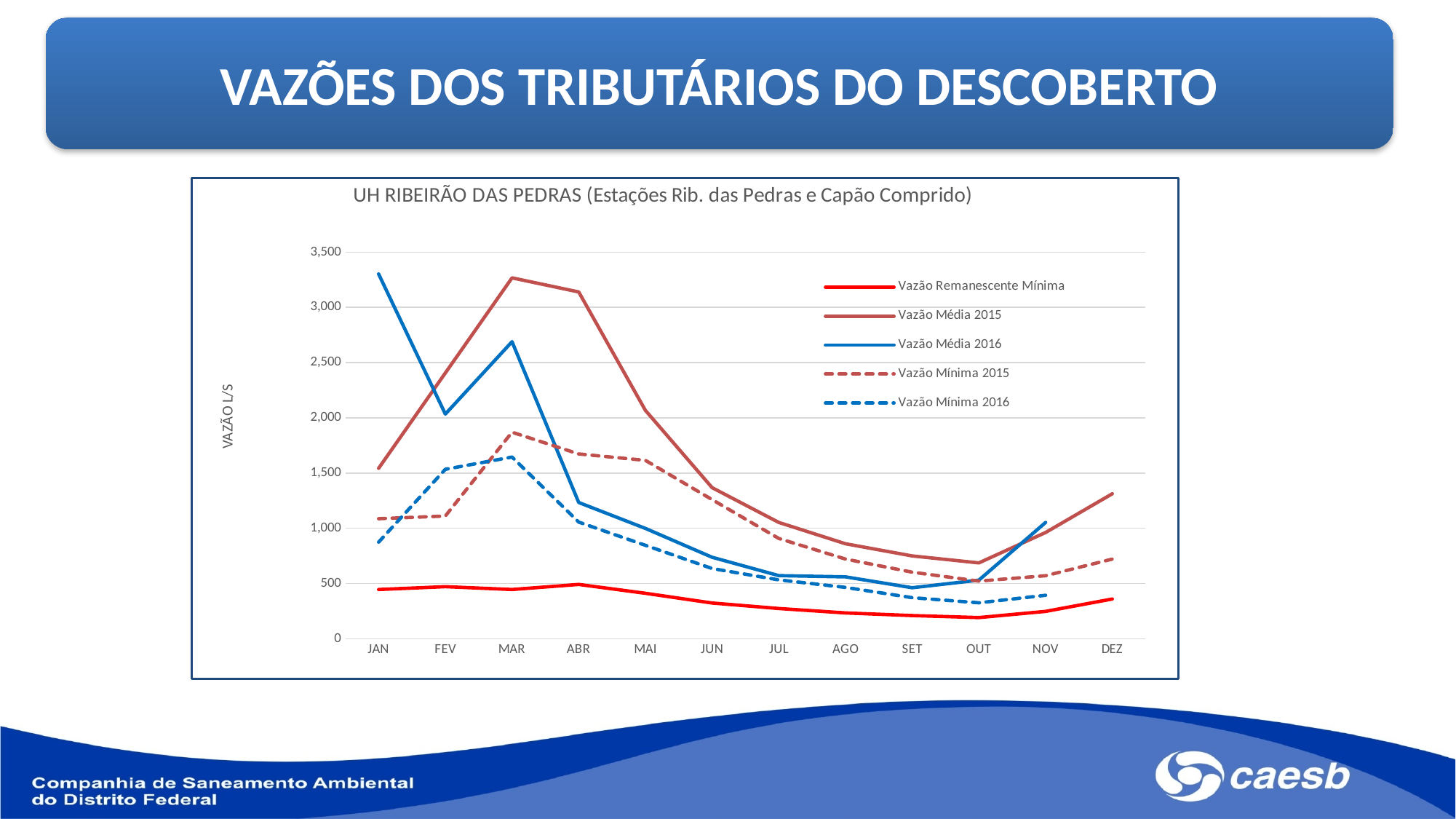
In which month does Vazão Mínima 2015 reach its highest value? MAR How many months are shown on the x axis? 12 In which month does Vazão Média 2015 reach its highest value? MAR In JAN, which is larger: Vazão Média 2015 or Vazão Média 2016? Vazão Média 2016 What kind of chart is shown on the slide? line chart Does Vazão Média 2015 rise or fall from MAR to OUT? fall How many series does the legend list? 5 What is the title of the vertical axis? VAZÃO L/S Is the value for Vazão Média 2015 in OUT greater or less than 1,000? less In which month does Vazão Média 2016 reach its highest value? JAN In which month is Vazão Média 2015 at its lowest? OUT Is the value for Vazão Média 2016 in JAN greater or less than 3,000? greater